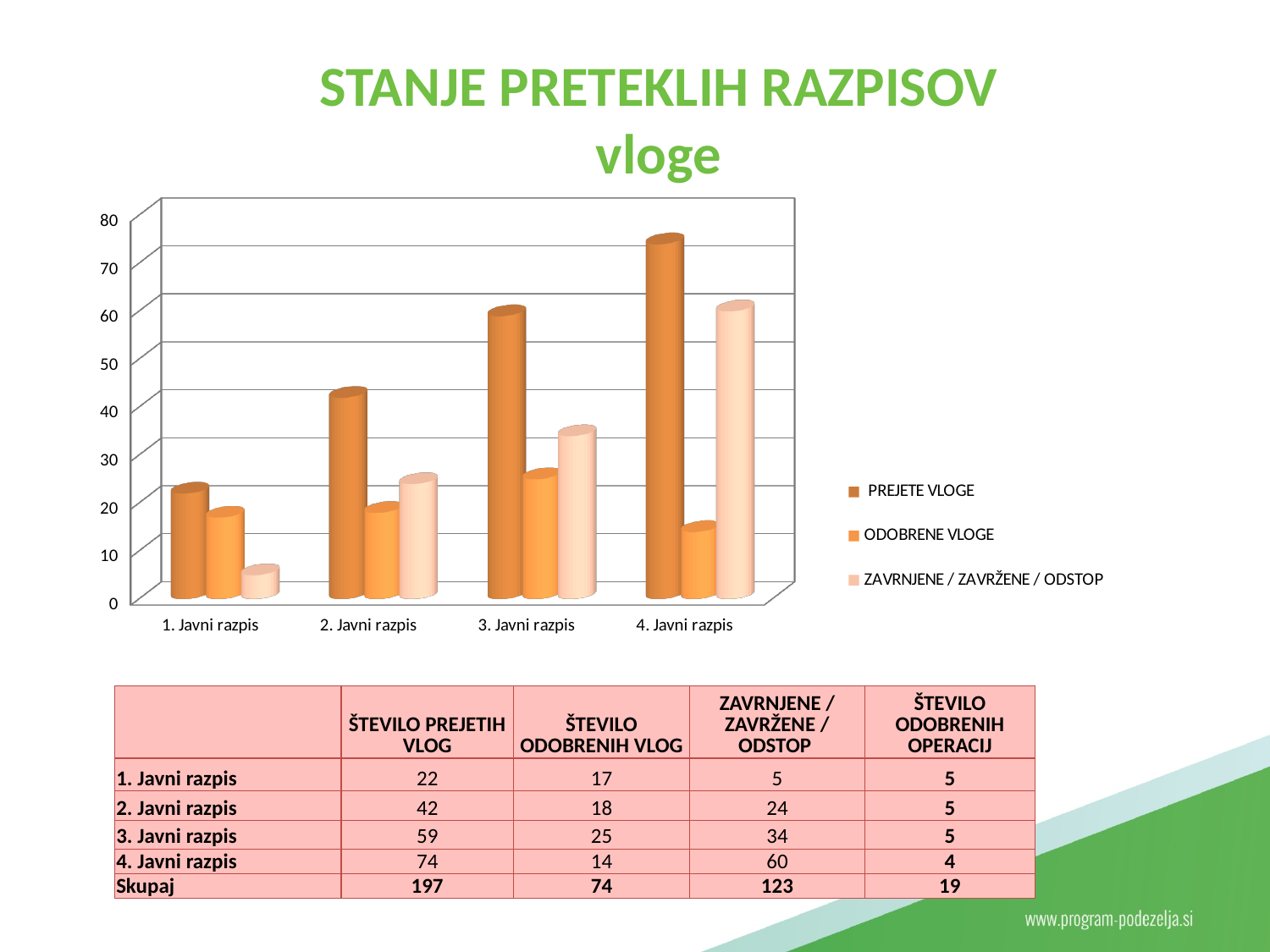
Do the values for PREJETE VLOGE rise or fall from 1. Javni razpis to 4. Javni razpis? rise What kind of chart is shown on the slide? bar chart Is the value for PREJETE VLOGE in 4. Javni razpis greater or less than 70? greater How many categories are shown on the x axis of the chart? 4 Which category has the lowest value for ZAVRNJENE / ZAVRŽENE / ODSTOP? 1. Javni razpis According to the table on the slide, what is the number of received applications (ŠTEVILO PREJETIH VLOG) for 3. Javni razpis? 59 Which is larger in 3. Javni razpis: ODOBRENE VLOGE or ZAVRNJENE / ZAVRŽENE / ODSTOP? ZAVRNJENE / ZAVRŽENE / ODSTOP Is the value for ODOBRENE VLOGE in 2. Javni razpis greater or less than 20? less According to the table on the slide, what is the difference between ŠTEVILO PREJETIH VLOG and ŠTEVILO ODOBRENIH VLOG for 4. Javni razpis? 60 Which category has the highest value for PREJETE VLOGE? 4. Javni razpis What is the title of the chart on the slide? STANJE PRETEKLIH RAZPISOV vloge How many series does the chart legend list? 3